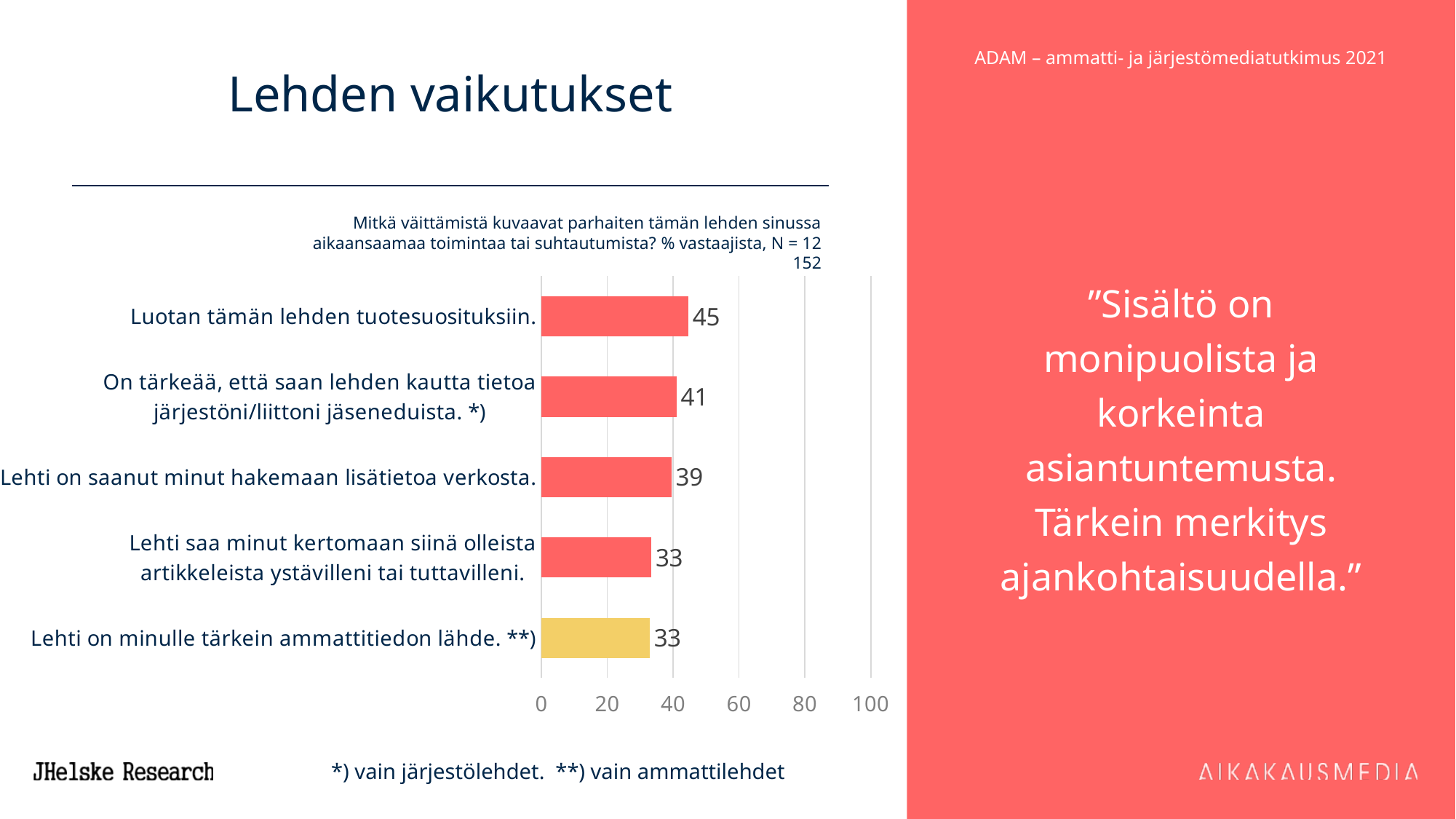
What is the difference between the values for "Luotan tämän lehden tuotesuosituksiin." and "Lehti on minulle tärkein ammattitiedon lähde. **)"? 12 What is the value for "Lehti on minulle tärkein ammattitiedon lähde. **)"? 33 Which category's bar is coloured yellow instead of red? Lehti on minulle tärkein ammattitiedon lähde. **) Is the value for "Luotan tämän lehden tuotesuosituksiin." greater or less than 40? greater Which category has the highest value? Luotan tämän lehden tuotesuosituksiin. Which is larger: the value for "On tärkeää, että saan lehden kautta tietoa järjestöni/liittoni jäseneduista. *)" or the value for "Lehti on saanut minut hakemaan lisätietoa verkosta."? On tärkeää, että saan lehden kautta tietoa järjestöni/liittoni jäseneduista. *) What is the value for "Luotan tämän lehden tuotesuosituksiin."? 45 How many categories are shown in the chart? 5 What kind of chart is shown on the slide? bar chart What is the value for "Lehti on saanut minut hakemaan lisätietoa verkosta."? 39 What is the value for "On tärkeää, että saan lehden kautta tietoa järjestöni/liittoni jäseneduista. *)"? 41 What is the title of the slide? Lehden vaikutukset